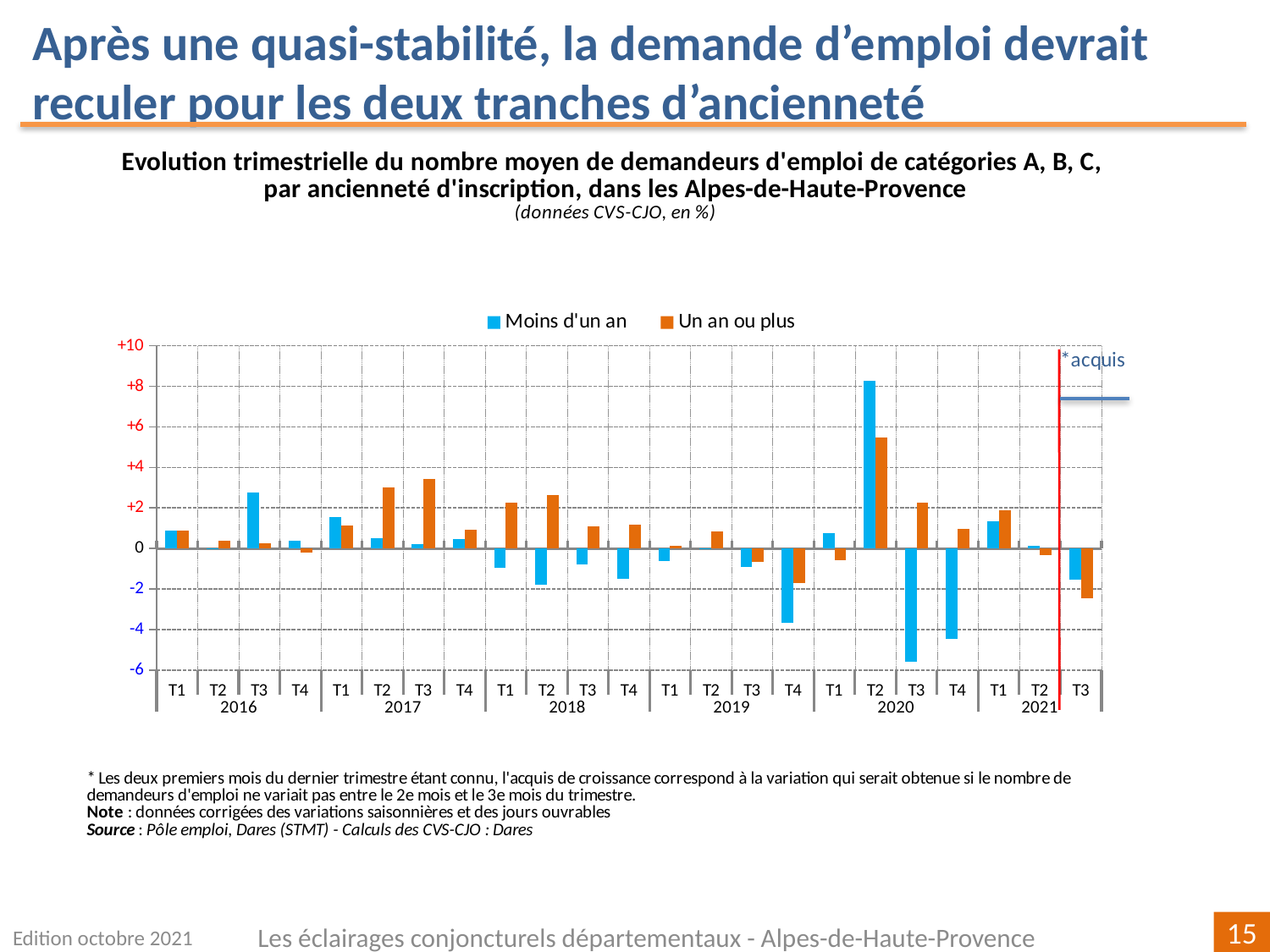
How many quarters are plotted along the x axis? 23 What kind of chart is shown on the slide? bar chart How many series does the legend list? 2 In which quarter does the 'Moins d'un an' series reach its highest value? T2 2020 In T3 2017, which series has the larger value, 'Moins d'un an' or 'Un an ou plus'? Un an ou plus In which quarter does the 'Moins d'un an' series reach its lowest value? T3 2020 Is the value for 'Moins d'un an' in T3 2020 greater or less than -4? less In which quarter does the 'Un an ou plus' series reach its highest value? T2 2020 In T2 2020, which series has the larger value, 'Moins d'un an' or 'Un an ou plus'? Moins d'un an Is the value for 'Un an ou plus' in T3 2017 greater or less than +2? greater Is the value for 'Moins d'un an' in T2 2020 greater or less than +6? greater What are the two series named in the legend? Moins d'un an; Un an ou plus